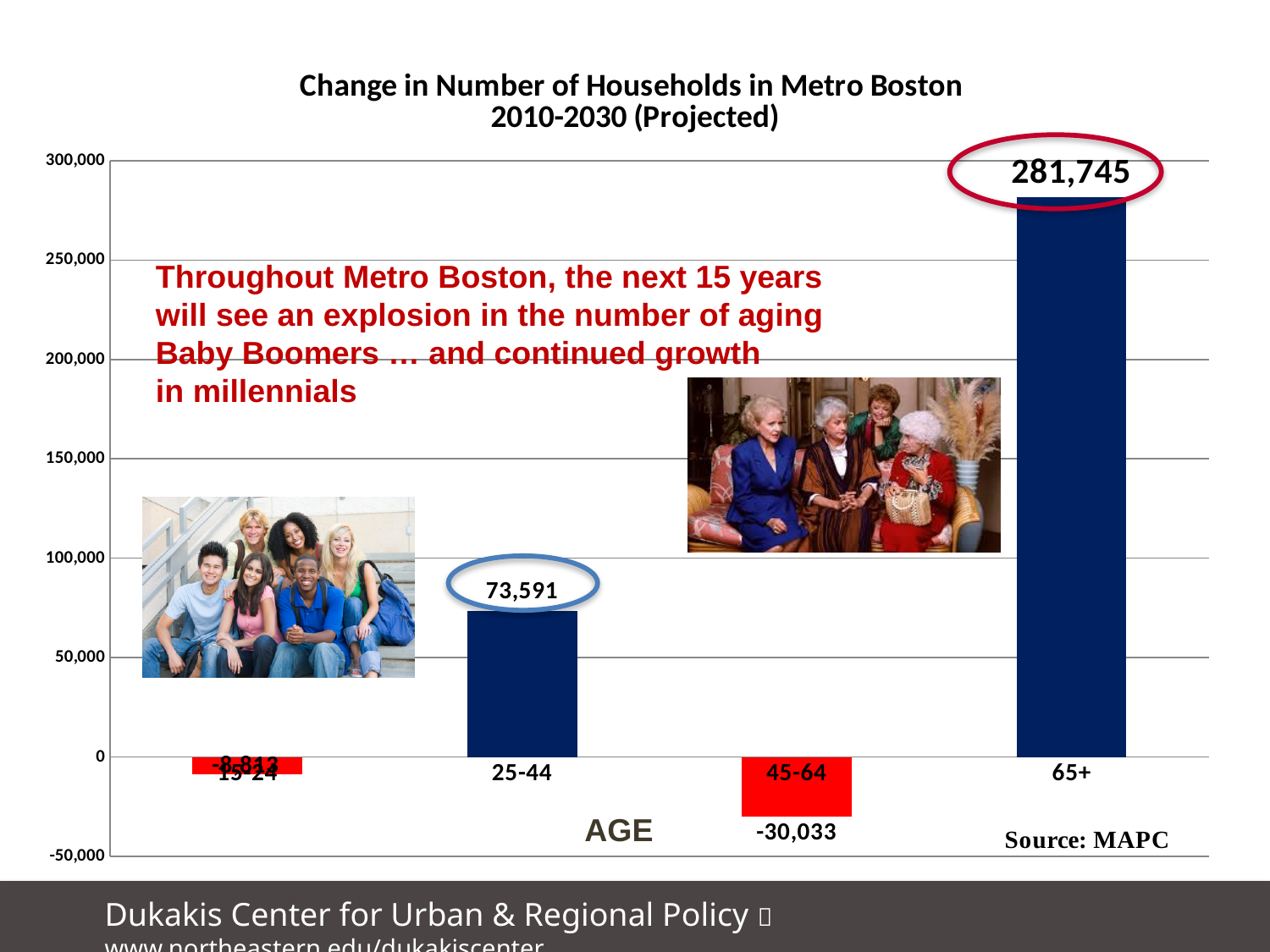
What kind of chart is shown on the slide? bar chart What is the difference between the values for the 25-44 and 45-64 age groups? 103,624 What is the projected change in number of households for the 45-64 age group? -30,033 What is the projected change in number of households for the 65+ age group? 281,745 What is the projected change in number of households for the 25-44 age group? 73,591 Is the value for the 65+ age group greater or less than 250,000? greater What is the source cited for the chart data? MAPC How much larger is the projected change for the 65+ group than for the 25-44 group? 208,154 How many age groups are shown on the chart? 4 Which age group has the lowest projected change in number of households? 45-64 Which age group has the highest projected change in number of households? 65+ Which has a larger projected change in households, the 25-44 group or the 45-64 group? 25-44